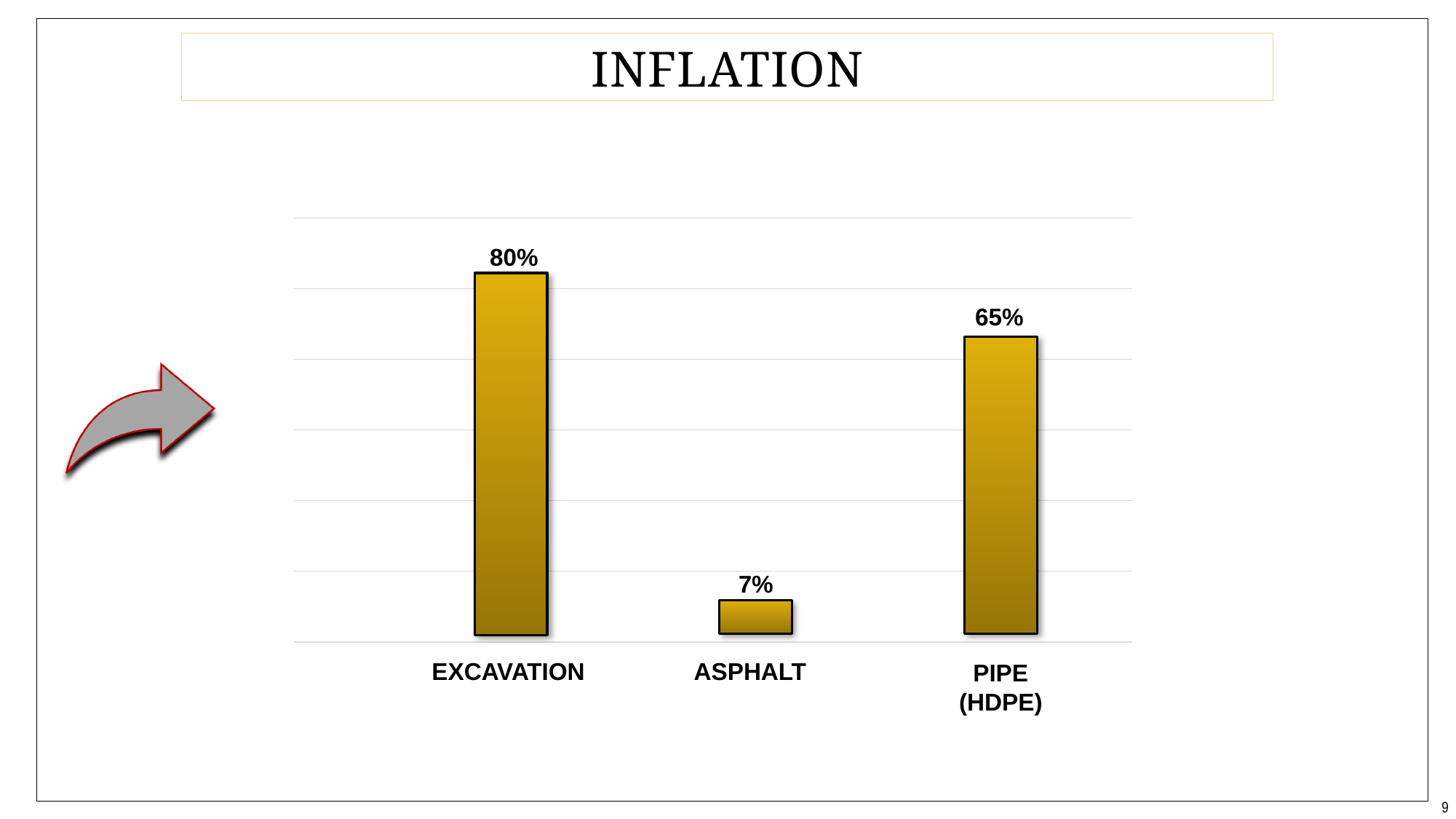
Which category has the highest value? EXCAVATION What kind of chart is shown on the slide? bar chart How many categories are shown in the chart? 3 What colour are the bars in the chart? gold Which category has the lowest value? ASPHALT What is the value for EXCAVATION? 80% What is the difference between the values for EXCAVATION and PIPE (HDPE)? 15% What is the value for ASPHALT? 7% Which is larger, the value for ASPHALT or the value for PIPE (HDPE)? PIPE (HDPE) What is the difference between the values for PIPE (HDPE) and ASPHALT? 58% What is the title of the slide containing the chart? INFLATION What is the value for PIPE (HDPE)? 65%